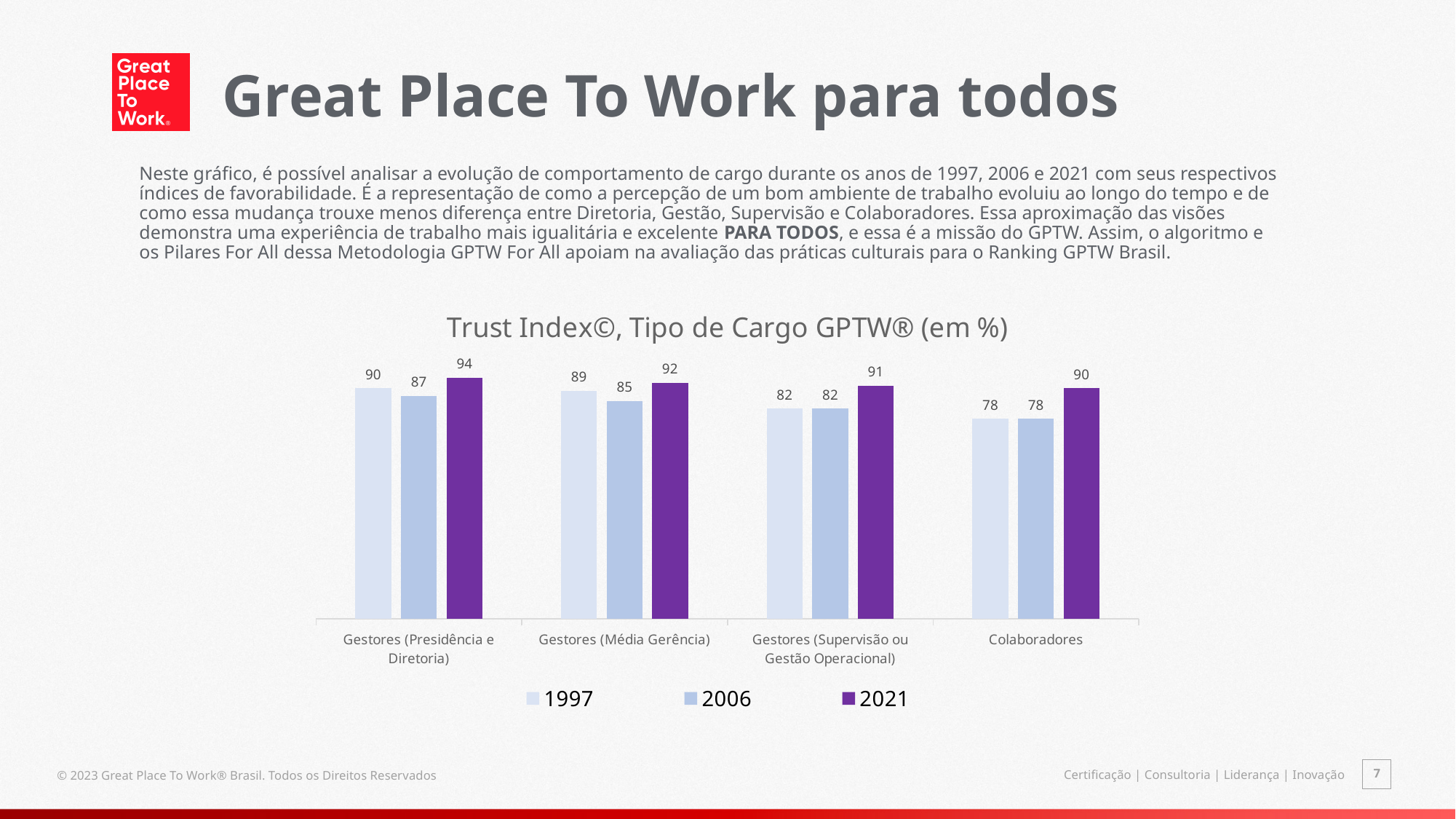
Which category has the lowest 1997 value? Colaboradores What is the 2021 value for Colaboradores? 90 Which is larger: the 2006 value for Gestores (Média Gerência) or the 2006 value for Gestores (Supervisão ou Gestão Operacional)? Gestores (Média Gerência) How many categories are shown on the x axis? 4 What is the 2006 value for Gestores (Supervisão ou Gestão Operacional)? 82 What kind of chart is shown on the slide? Bar chart How many series does the legend list? 3 What is the title of the chart? Trust Index©, Tipo de Cargo GPTW® (em %) What is the 1997 value for Gestores (Média Gerência)? 89 Which category has the highest 2021 value? Gestores (Presidência e Diretoria) What is the difference between the 1997 and 2006 values for Gestores (Presidência e Diretoria)? 3 What is the difference between the 2021 and 1997 values for Colaboradores? 12